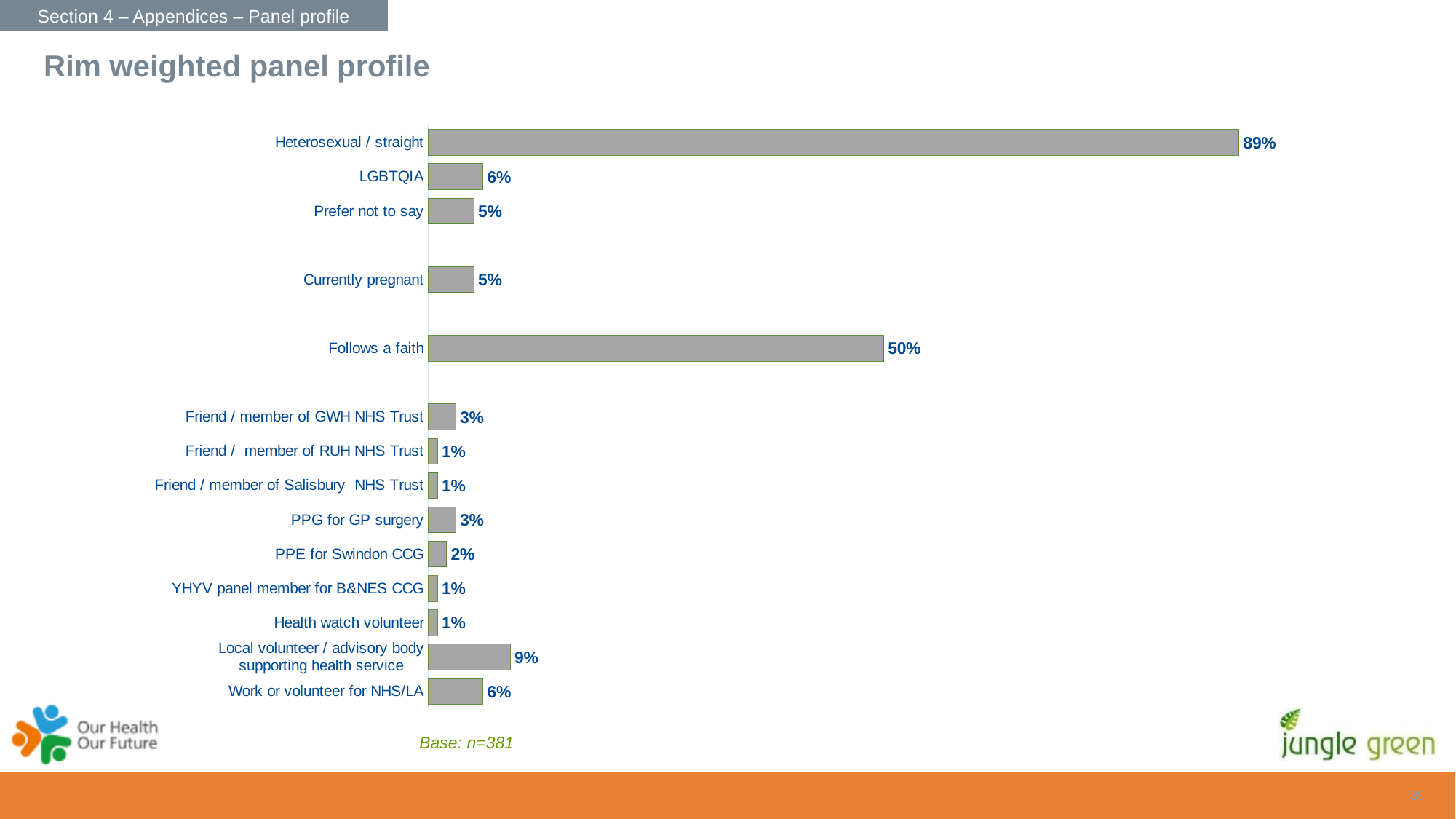
Which is larger, the value for PPG for GP surgery or the value for Work or volunteer for NHS/LA? Work or volunteer for NHS/LA What is the value for Currently pregnant? 5% What is the value for Local volunteer / advisory body supporting health service? 9% What is the difference between the values for Heterosexual / straight and Follows a faith? 39% How many categories are shown in the chart? 14 What is the difference between the values for LGBTQIA and Prefer not to say? 1% Which category has the highest value? Heterosexual / straight What base size is stated below the chart? n=381 What kind of chart is shown on the slide? Bar chart What is the value for Heterosexual / straight? 89% What is the value for PPE for Swindon CCG? 2% What is the value for Follows a faith? 50%